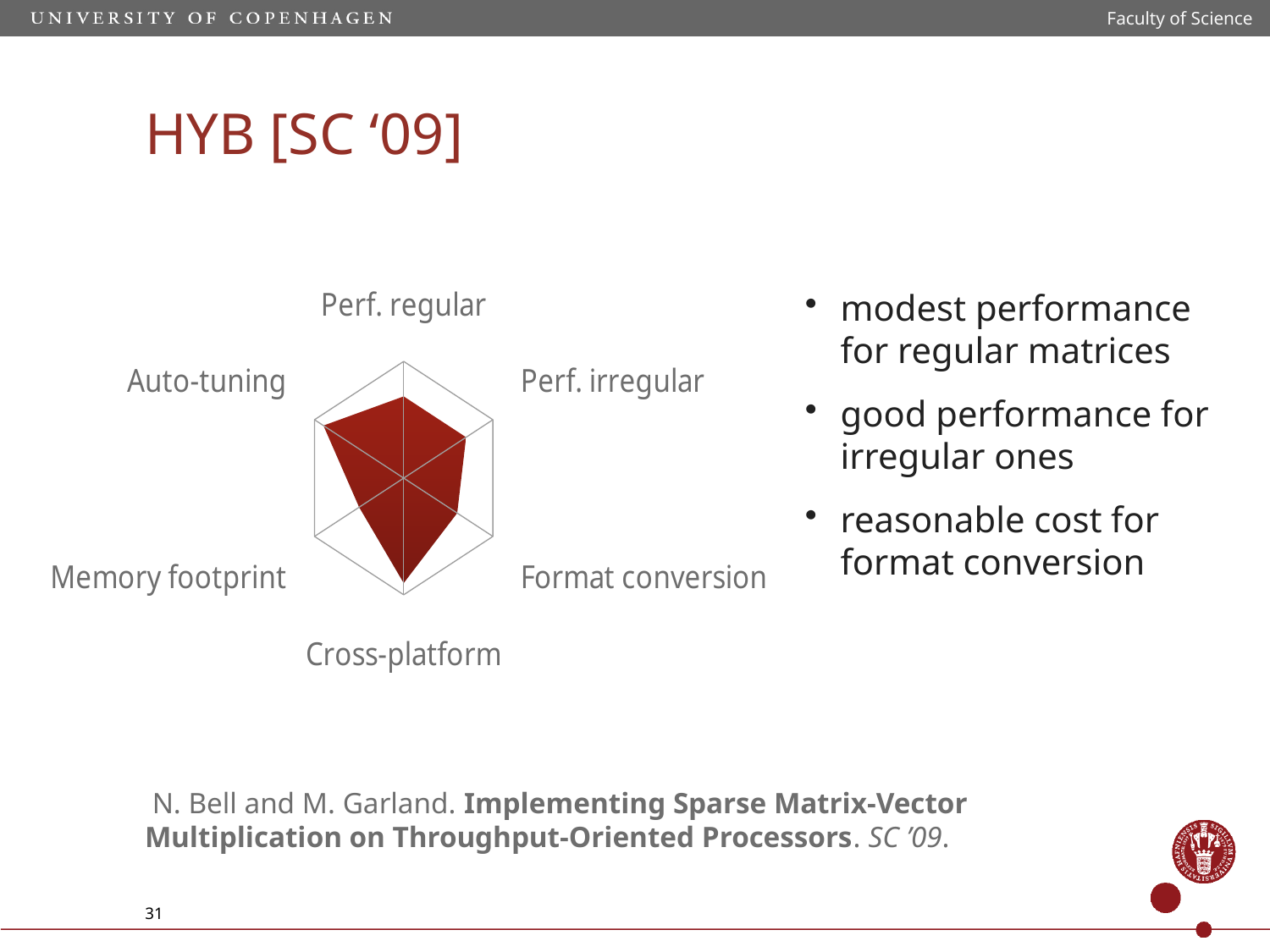
Which category is labelled at the bottom of the radar chart? Cross-platform Which category is labelled at the top of the radar chart? Perf. regular What kind of chart is shown on the slide? radar chart Is the value for Cross-platform larger or smaller than the value for Format conversion? larger How many axes (categories) does the radar chart have? 6 Is the value for Cross-platform larger or smaller than the value for Memory footprint? larger